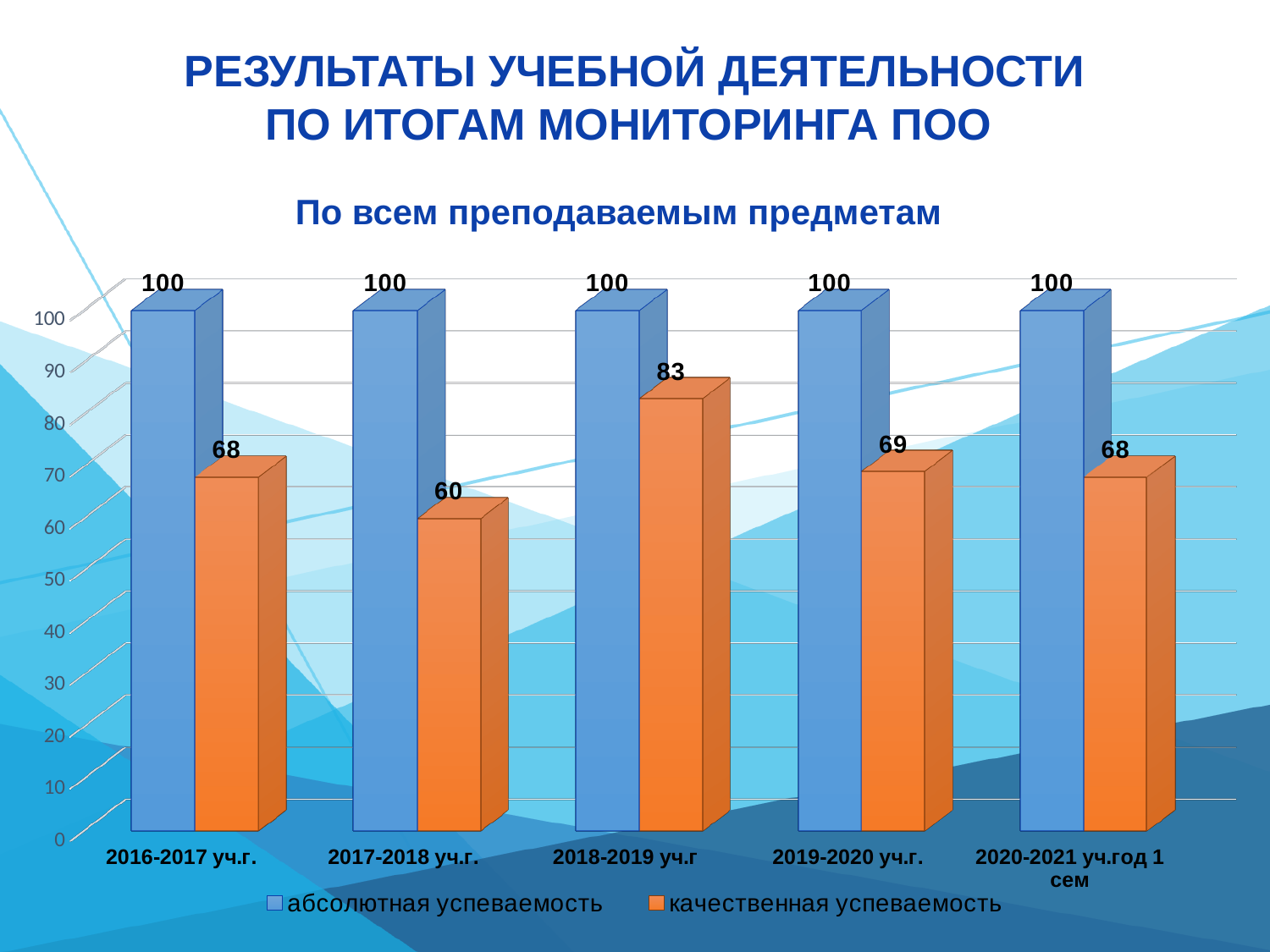
What is the difference in качественная успеваемость between 2018-2019 уч.г and 2019-2020 уч.г.? 14 What is the difference between абсолютная успеваемость and качественная успеваемость for 2017-2018 уч.г.? 40 How many series does the legend list? 2 Which category has the highest value of качественная успеваемость? 2018-2019 уч.г Which is larger: качественная успеваемость for 2016-2017 уч.г. or for 2017-2018 уч.г.? 2016-2017 уч.г. What colour are the bars for качественная успеваемость? orange What is the value of качественная успеваемость for 2018-2019 уч.г? 83 What is the value of абсолютная успеваемость for 2017-2018 уч.г.? 100 What is the value of качественная успеваемость for 2020-2021 уч.год 1 сем? 68 What kind of chart is shown on the slide? bar chart Which category has the lowest value of качественная успеваемость? 2017-2018 уч.г. How many categories are shown on the x axis? 5